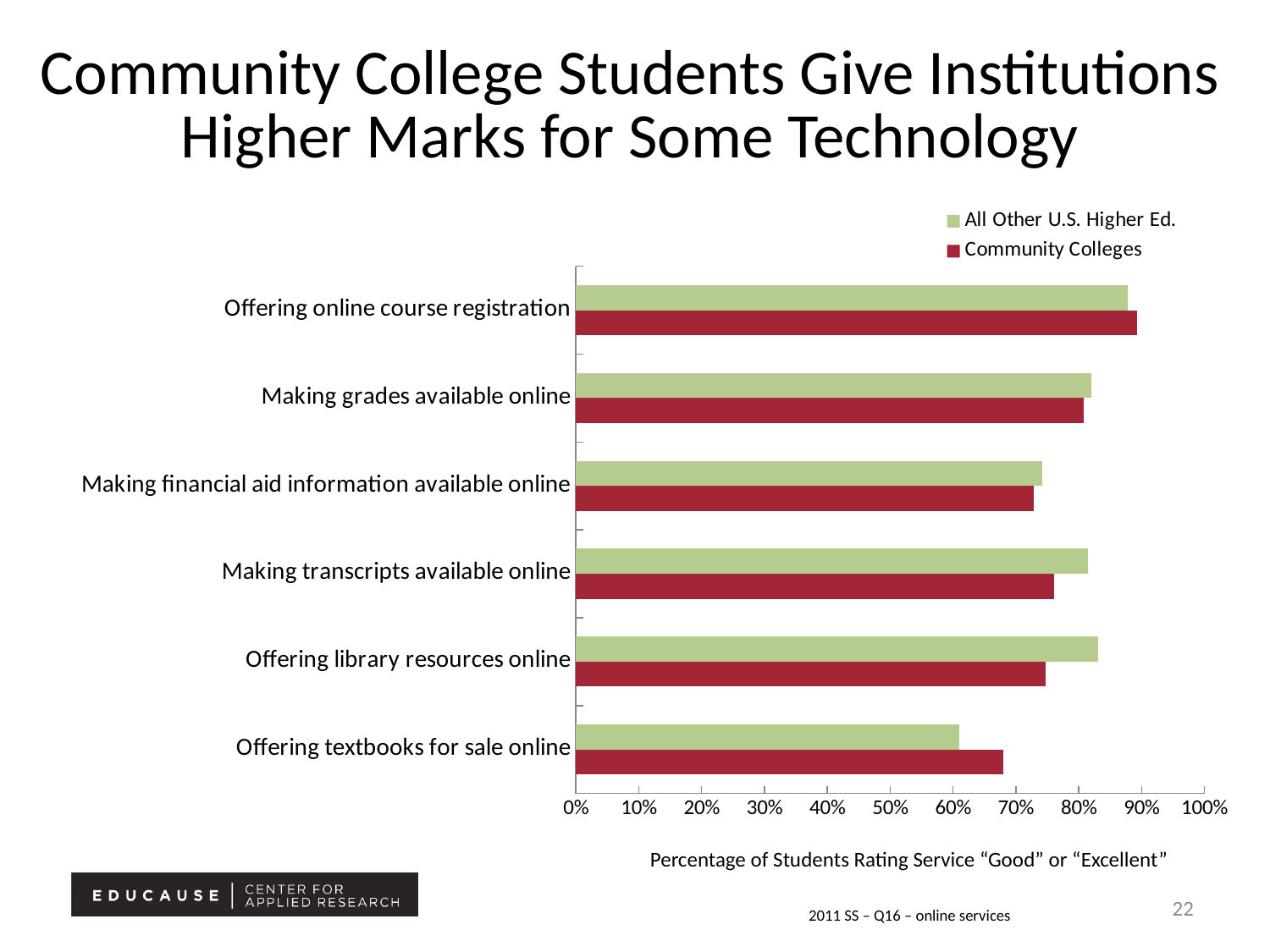
For Offering textbooks for sale online, which series has the larger value, Community Colleges or All Other U.S. Higher Ed.? Community Colleges For All Other U.S. Higher Ed., which service has the lowest percentage? Offering textbooks for sale online For Offering library resources online, which series has the larger value, Community Colleges or All Other U.S. Higher Ed.? All Other U.S. Higher Ed. Which series is shown in red? Community Colleges What kind of chart is shown on the slide? bar chart Is the Community Colleges value for Making financial aid information available online greater or less than 80%? less Is the All Other U.S. Higher Ed. value for Offering library resources online greater or less than 80%? greater How many service categories are plotted on the chart? 6 How many series does the legend list? 2 For Community Colleges, which service has the highest percentage? Offering online course registration Is the Community Colleges value for Offering textbooks for sale online greater or less than 60%? greater What is the x-axis label of the chart? Percentage of Students Rating Service "Good" or "Excellent"